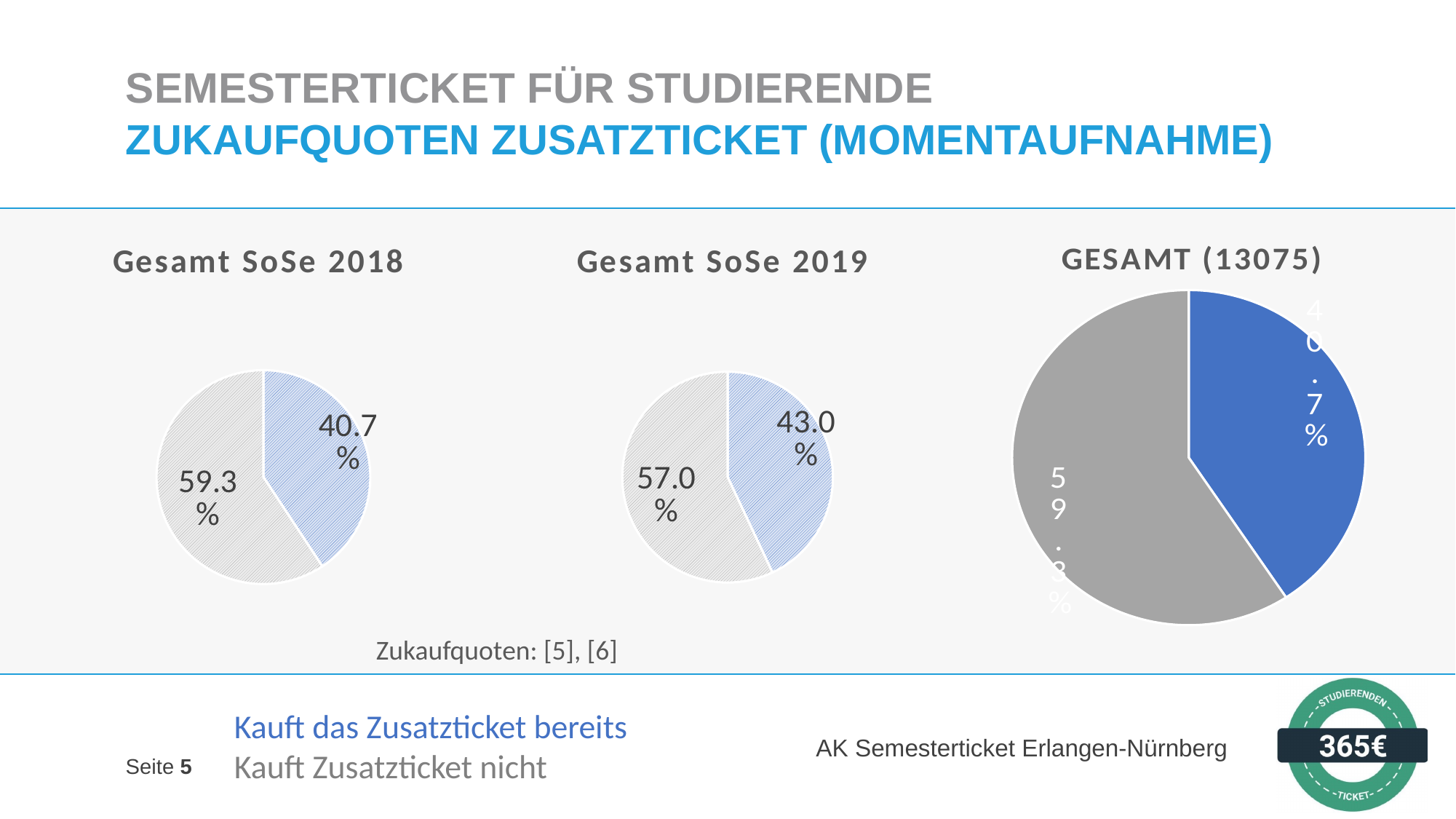
In the 'Gesamt SoSe 2018' pie chart, what share of students do not buy the Zusatzticket (Kauft Zusatzticket nicht)? 59.3% In the 'GESAMT (13075)' pie chart, what share of students do not buy the Zusatzticket? 59.3% What kind of chart is used for 'Gesamt SoSe 2018'? Pie chart Which category does the blue colour represent in the pie charts? Kauft das Zusatzticket bereits Comparing the 'Gesamt SoSe 2018' and 'Gesamt SoSe 2019' pie charts, by how many percentage points did the share of students already buying the Zusatzticket increase? 2.3% In the 'Gesamt SoSe 2018' pie chart, what share of students already buy the Zusatzticket (Kauft das Zusatzticket bereits)? 40.7% How many pie charts are shown on the slide? 3 In the 'Gesamt SoSe 2019' pie chart, what share of students already buy the Zusatzticket? 43.0% In the 'GESAMT (13075)' pie chart, what share of students already buy the Zusatzticket? 40.7% In the 'Gesamt SoSe 2019' pie chart, which slice is larger: 'Kauft das Zusatzticket bereits' or 'Kauft Zusatzticket nicht'? Kauft Zusatzticket nicht In the 'Gesamt SoSe 2018' pie chart, what is the difference between the share that does not buy the Zusatzticket and the share that already buys it? 18.6% In the 'Gesamt SoSe 2019' pie chart, what share of students do not buy the Zusatzticket? 57.0%